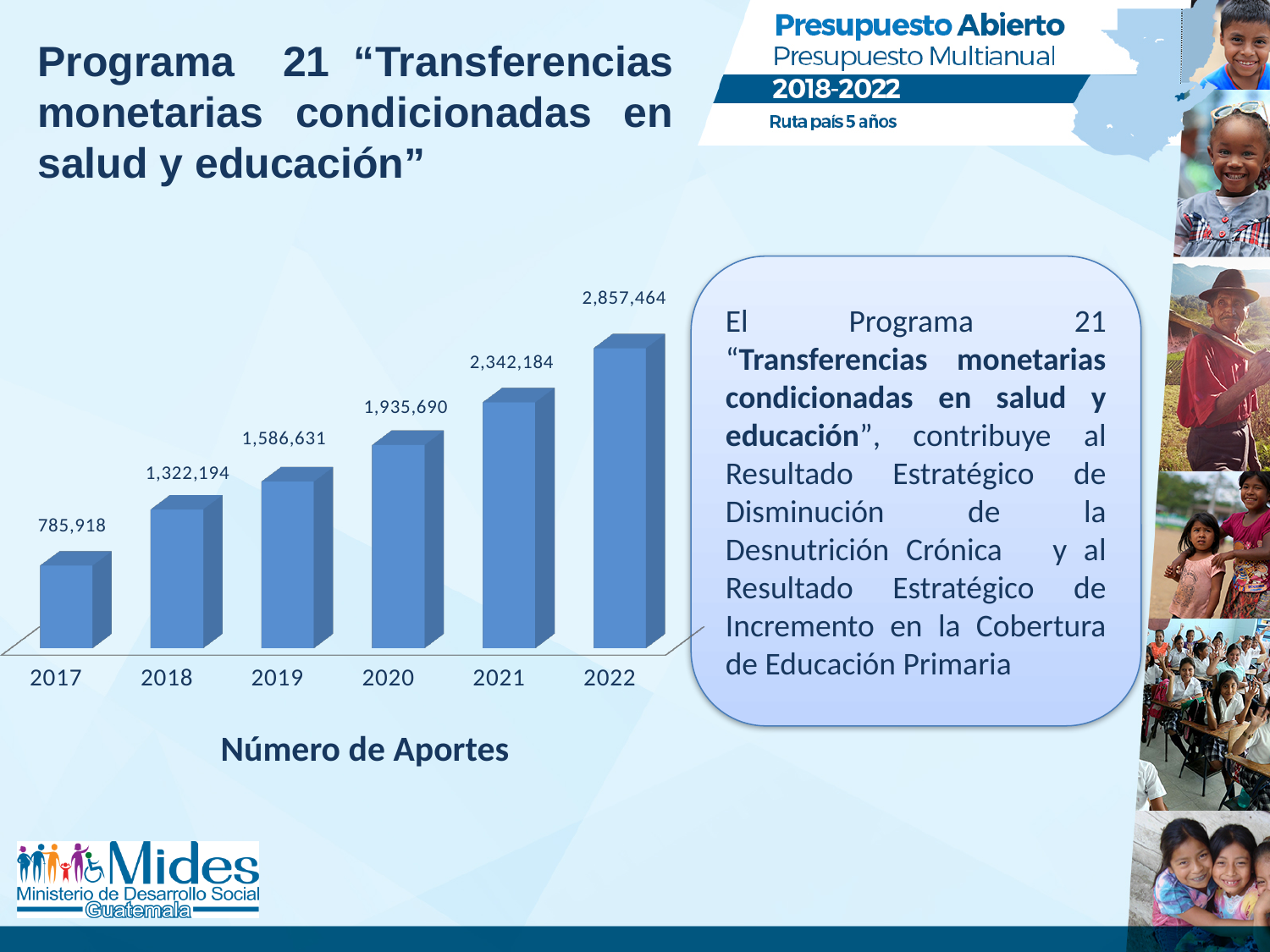
What is the difference between the values for 2018 and 2017? 536,276 Which is larger, the value for 2019 or the value for 2021? 2021 Which year has the highest value in the chart? 2022 What is the difference between the values for 2022 and 2021? 515,280 What is the value for 2020 in the chart? 1,935,690 How many years are shown in the chart? 6 What kind of chart is shown on the slide? Bar chart What is the value for 2022 in the chart? 2,857,464 What is the value for 2019 in the chart? 1,586,631 Do the values rise or fall from 2017 to 2022? Rise Which year has the lowest value in the chart? 2017 What is the value for 2017 in the chart? 785,918